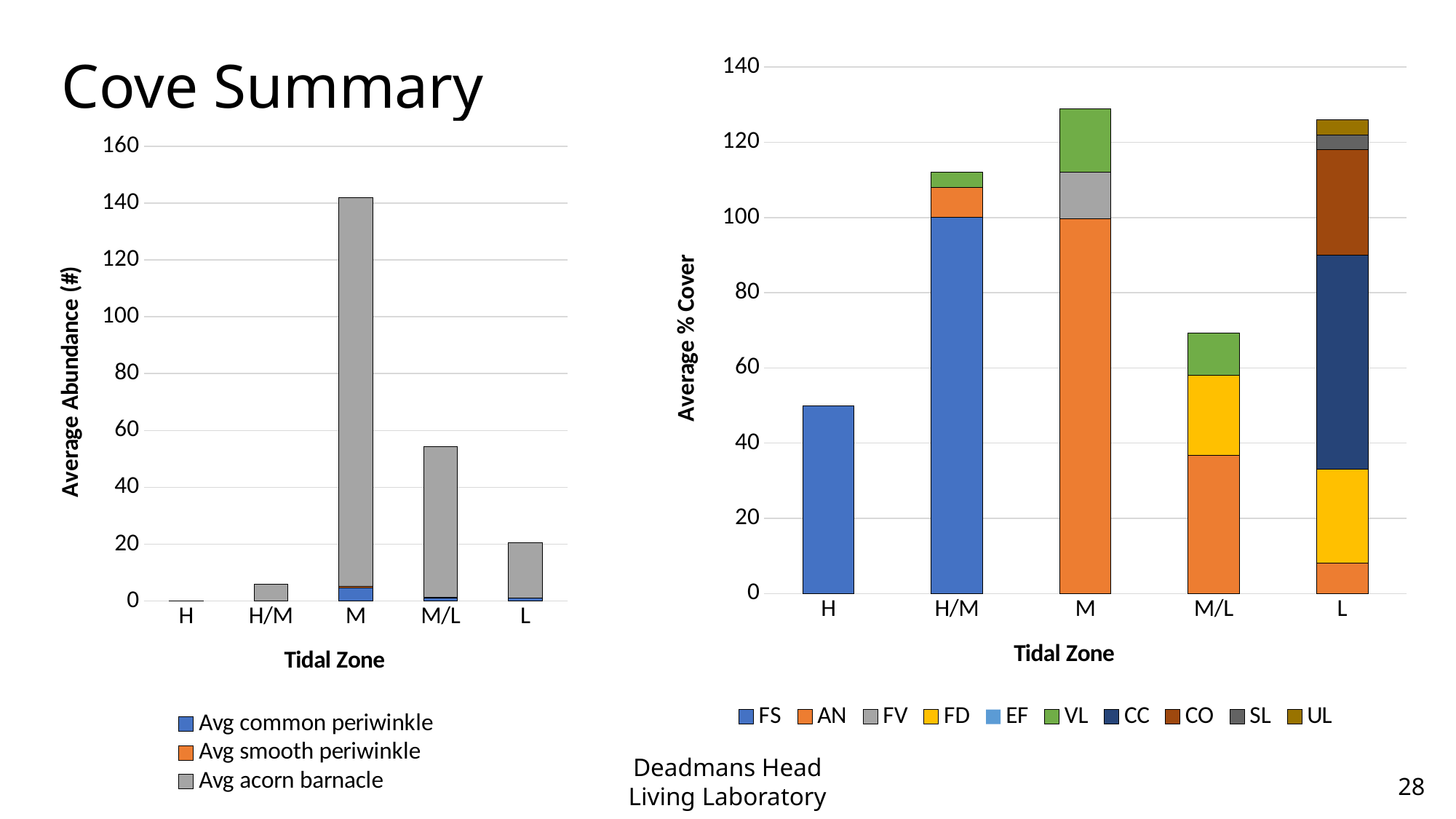
On the left chart (Average Abundance), which tidal zone has the highest total bar? M How many tidal zone categories are shown on the x axis of the right chart (Average % Cover)? 5 On the right chart (Average % Cover), how many series does the legend list? 10 On the left chart (Average Abundance), is the total value for L greater or less than 40? less On the right chart (Average % Cover), is the total value for M/L greater or less than 60? greater On the right chart (Average % Cover), which tidal zone has the highest total bar? M On the left chart (Average Abundance), is the total value for M/L greater or less than 40? greater On the left chart (Average Abundance), which tidal zone has the lowest total bar? H On the right chart (Average % Cover), which tidal zone has the lowest total bar? H On the left chart (Average Abundance), how many series does the legend list? 3 On the right chart (Average % Cover), which has the larger total bar, H/M or M/L? H/M